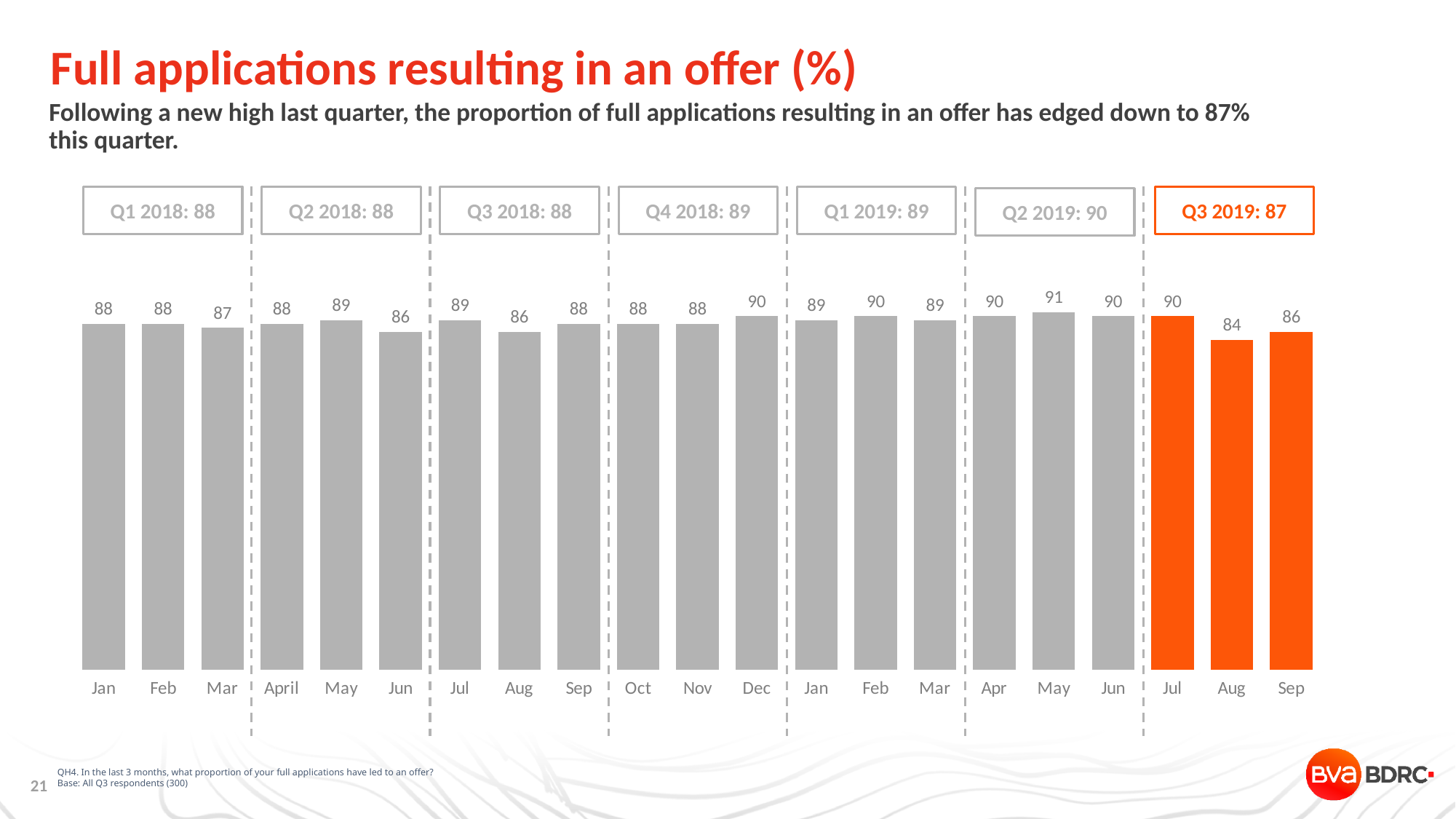
What is the difference between the values for Jul 2019 and Aug 2019? 6 Which quarter's bars are highlighted in orange rather than grey? Q3 2019 Which is larger, the value for Jun 2018 or the value for Jun 2019? Jun 2019 What is the value for Dec 2018 (in Q4 2018)? 90 How many monthly bars are plotted in the chart? 21 What is the value for Aug 2019 (in Q3 2019)? 84 What is the value for May 2019 (in Q2 2019)? 91 What is the difference between the quarterly figures for Q2 2019 and Q3 2019? 3 What is the quarterly figure shown in the box for Q3 2019? 87 What type of chart is shown on the slide? bar chart Which month has the highest value in the chart? May 2019 Which month has the lowest value in the chart? Aug 2019